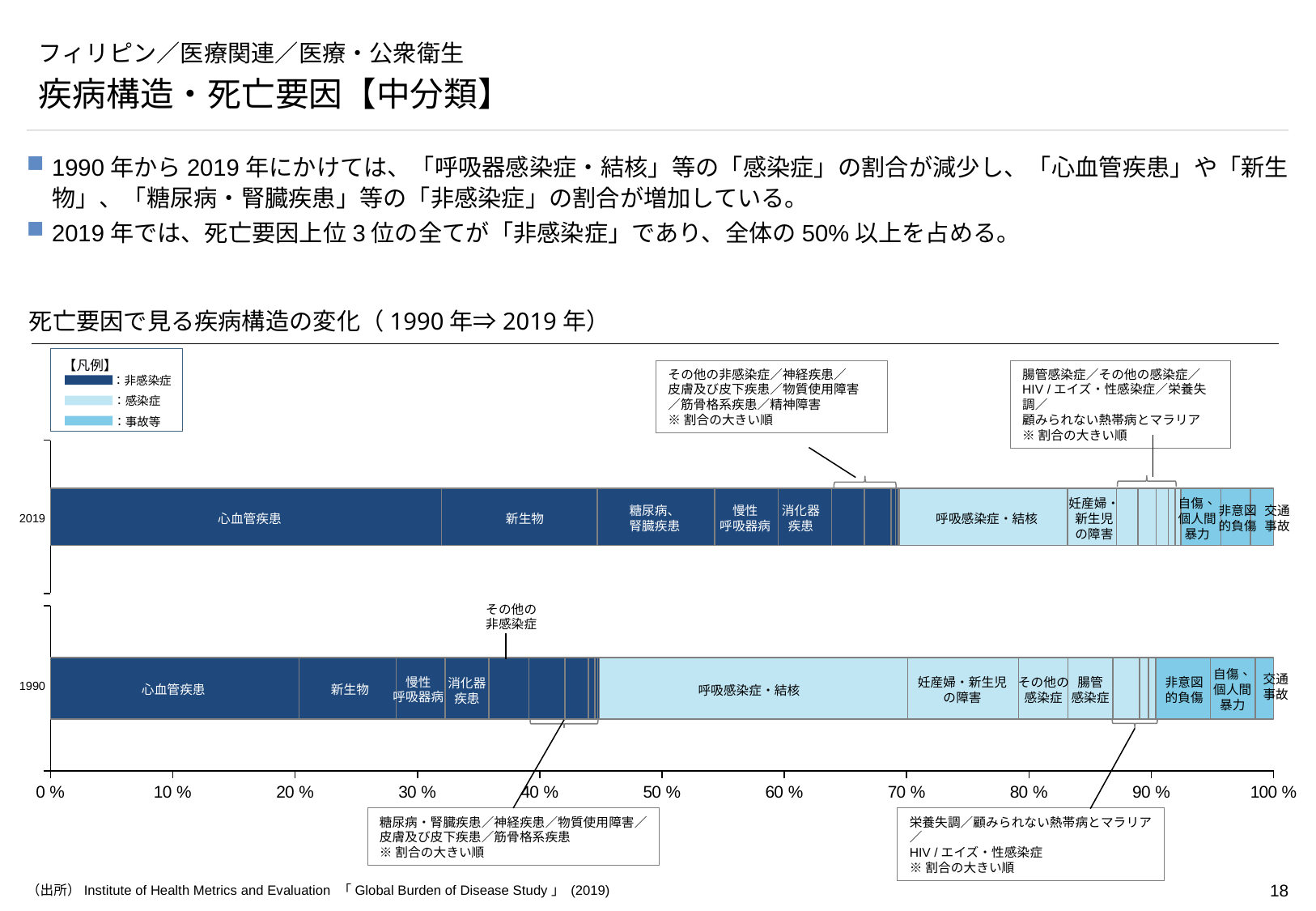
What is the title of the chart? 死亡要因で見る疾病構造の変化（1990年⇒2019年） How many years (bars) are plotted in the chart? 2 What kind of chart is shown on the slide? stacked bar chart Is the share of 呼吸感染症・結核 in 2019 greater or less than 20%? less How many categories does the legend (凡例) list? 3 Did the share of 呼吸感染症・結核 rise or fall from 1990 to 2019? fall Which cause of death has the largest share in the 1990 bar? 呼吸感染症・結核 Which cause of death has the largest share in the 2019 bar? 心血管疾患 Is the share of 呼吸感染症・結核 in 1990 greater or less than 20%? greater Is the share of 心血管疾患 larger in 2019 or in 1990? 2019 Is the share of 心血管疾患 in 2019 greater or less than 20%? greater Is the share of 呼吸感染症・結核 larger in 1990 or in 2019? 1990